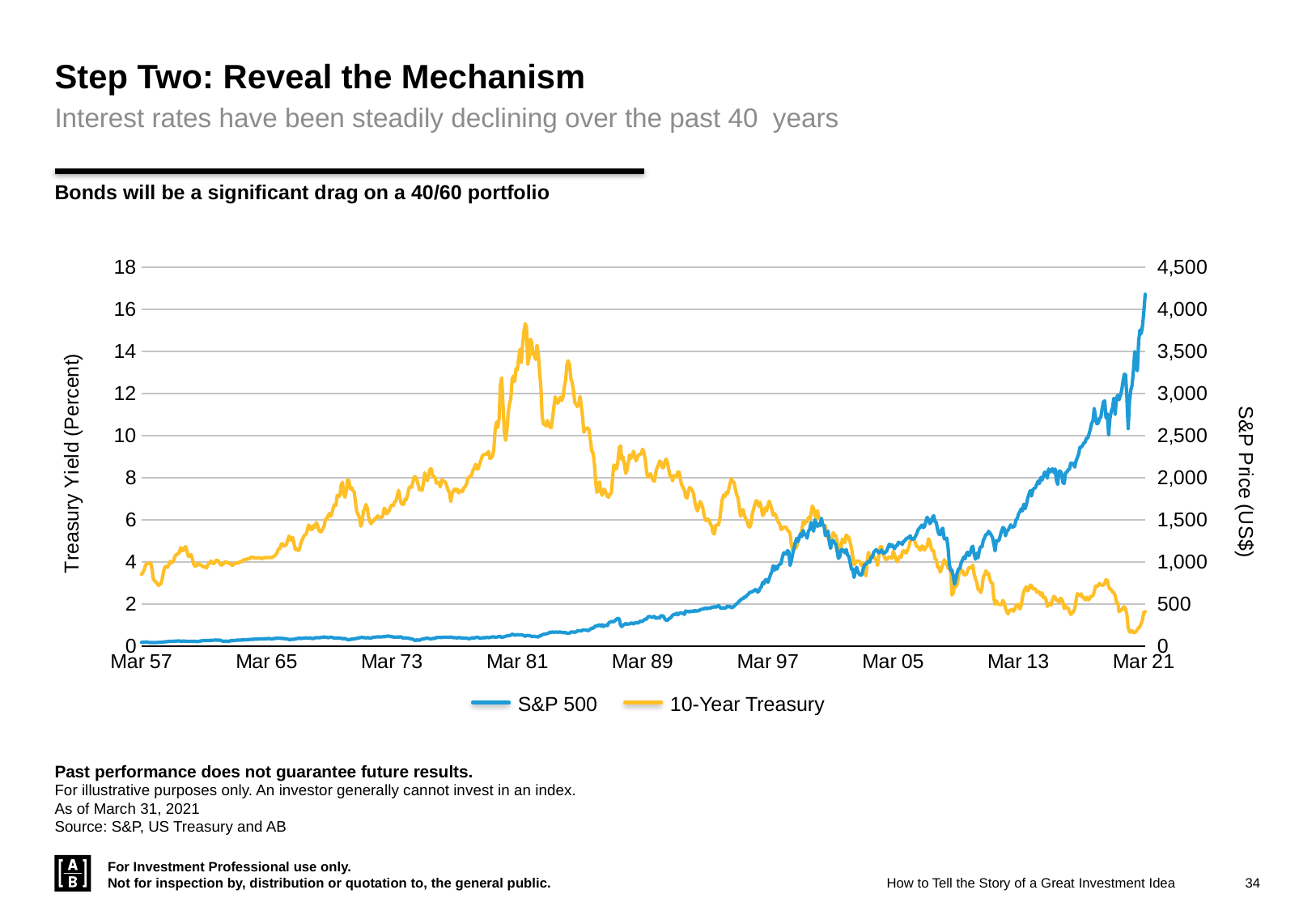
Is the value of the 10-Year Treasury series at Mar 57 greater or less than 6? less How many series does the legend list? 2 How many date labels are shown along the x axis? 9 What is the label of the left vertical axis? Treasury Yield (Percent) What is the title of the chart? Bonds will be a significant drag on a 40/60 portfolio Is the value of the 10-Year Treasury series at Mar 21 greater or less than 4? less Does the 10-Year Treasury series rise or fall overall from Mar 81 to Mar 21? fall Does the S&P 500 series rise or fall overall from Mar 97 to Mar 21? rise Is the value of the S&P 500 series at Mar 57 greater or less than 500? less What kind of chart is shown on the slide? Line chart